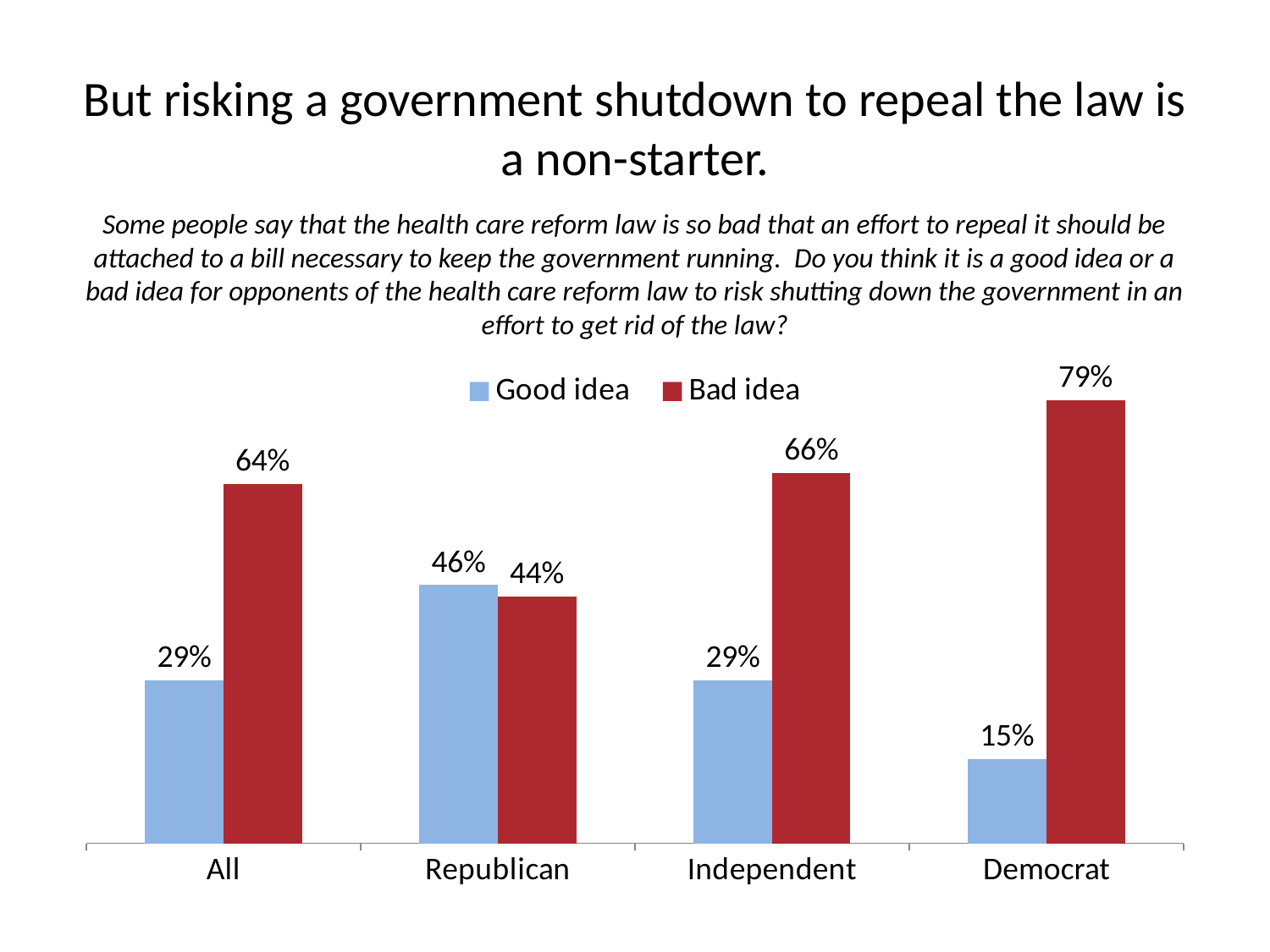
What percentage of Democrats say risking a government shutdown is a bad idea? 79% For Republicans, which is larger: the 'Good idea' value or the 'Bad idea' value? Good idea Which colour represents the 'Bad idea' series? Red What kind of chart is shown on the slide? Bar chart Which category has the lowest 'Good idea' value? Democrat How many categories are shown on the x axis? 4 What is the difference between the 'Bad idea' and 'Good idea' values for Democrats? 64 percentage points What is the 'Good idea' value for Independents? 29% What percentage of Republicans say risking a government shutdown is a good idea? 46% Which category has the highest 'Bad idea' value? Democrat What is the 'Bad idea' value for the All category? 64% How many series does the legend list? 2